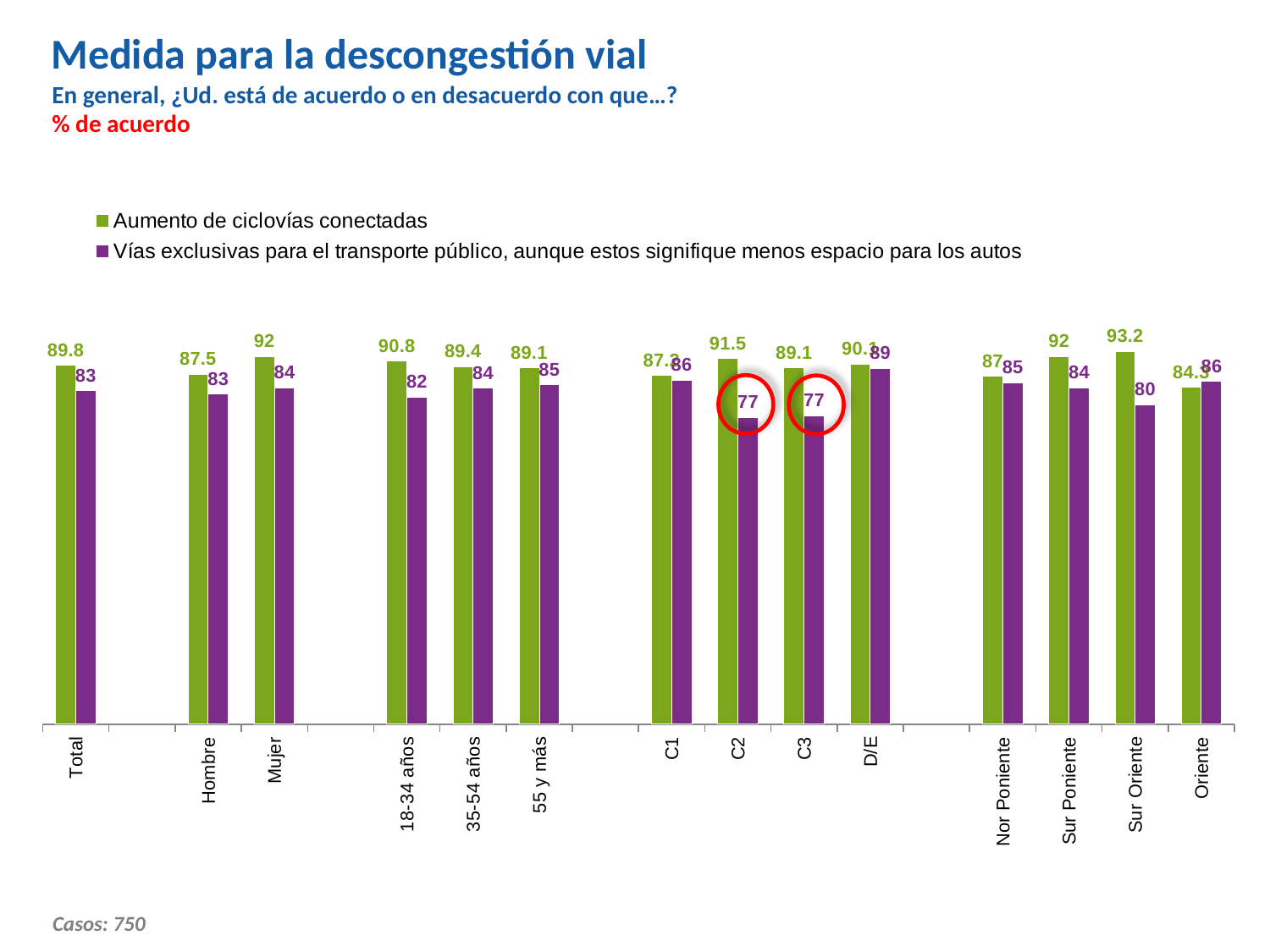
What is the value for 18-34 años in the 'Vías exclusivas para el transporte público' series? 82 What kind of chart is shown on the slide? Bar chart How many categories are shown on the x axis? 14 What is the value for Total in the 'Aumento de ciclovías conectadas' series? 89.8 What is the value for C2 in the 'Vías exclusivas para el transporte público' series? 77 What is the value for Mujer in the 'Vías exclusivas para el transporte público' series? 84 Which category has the highest value in the 'Aumento de ciclovías conectadas' series? Sur Oriente What is the difference between the two series for Sur Oriente? 13.2 Which category has the highest value in the 'Vías exclusivas para el transporte público' series? D/E Which is larger in the 'Aumento de ciclovías conectadas' series: Hombre or Mujer? Mujer What is the difference between the two series for C2? 14.5 How many series does the legend list? 2